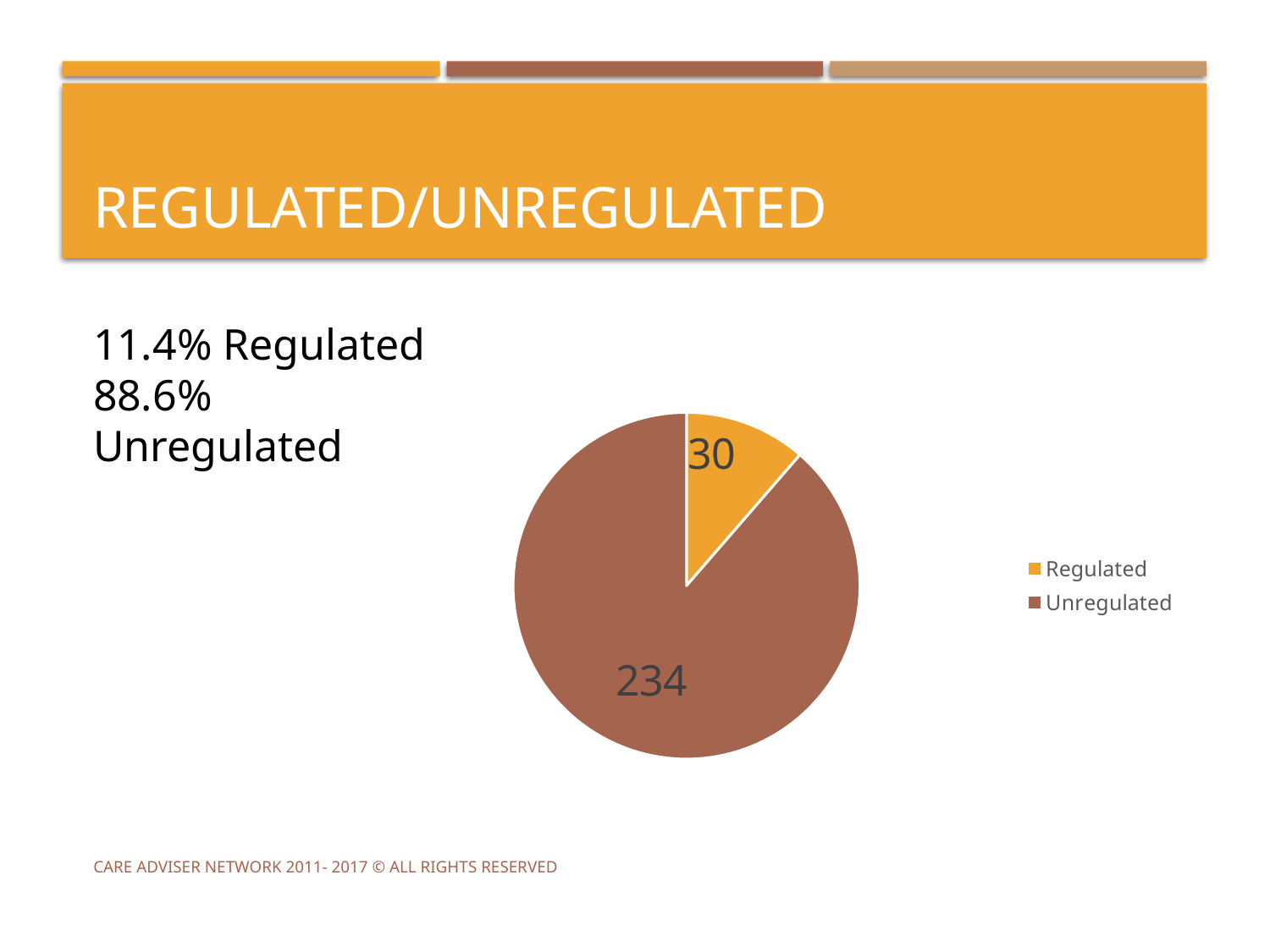
What kind of chart is shown on the slide? pie chart What is the value for Unregulated in the pie chart? 234 Which category has the largest slice in the pie chart? Unregulated What is the value for Regulated in the pie chart? 30 What is the total of the two values shown in the pie chart? 264 What is the difference between the Unregulated and Regulated values? 204 How many slices does the pie chart have? 2 How many entries does the legend list? 2 What share of the pie does the Regulated slice represent, as stated on the slide? 11.4% Which is larger, the Regulated slice or the Unregulated slice? Unregulated Which category has the smallest slice in the pie chart? Regulated What colour is the Unregulated slice in the pie chart? brown